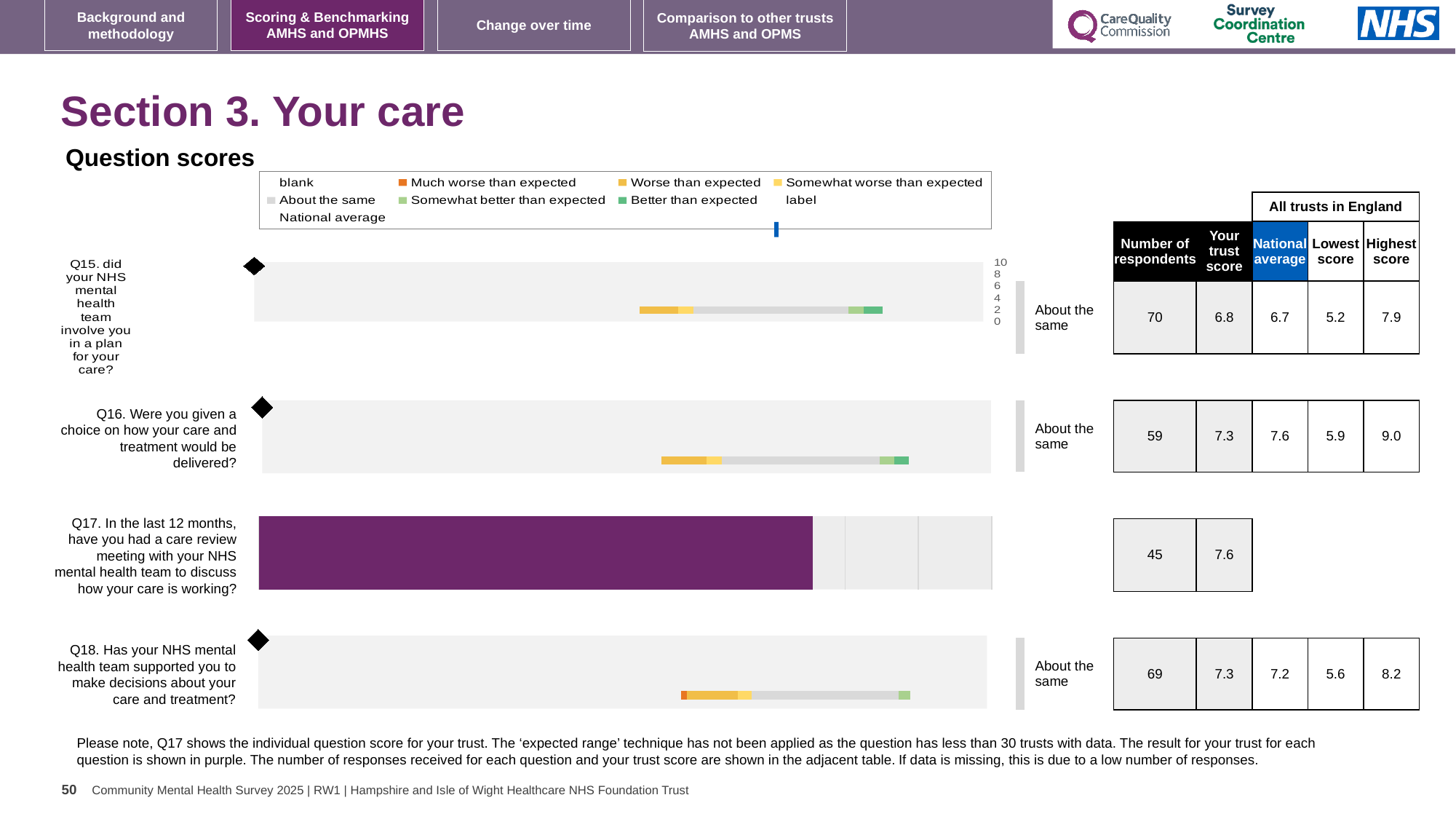
What is the national average score for Q16 (were you given a choice on how your care and treatment would be delivered)? 7.6 How many respondents answered Q18 (has your NHS mental health team supported you to make decisions about your care and treatment)? 69 What is the difference between the highest score and the lowest score for Q16? 3.1 How many questions are shown in the Question scores chart? 4 What is the lowest score among all trusts in England for Q18? 5.6 What type of chart is used to show the question scores? Bar chart What is the 'Your trust score' value for Q15 (did your NHS mental health team involve you in a plan for your care)? 6.8 By how much does the trust score for Q18 exceed the national average? 0.1 Which question has the lowest number of respondents? Q17 What colour is the bar for Q17 in the chart? Purple Which question has the highest 'Highest score' value among all trusts in England? Q16 For Q15, which is larger: the trust score or the national average? Your trust score